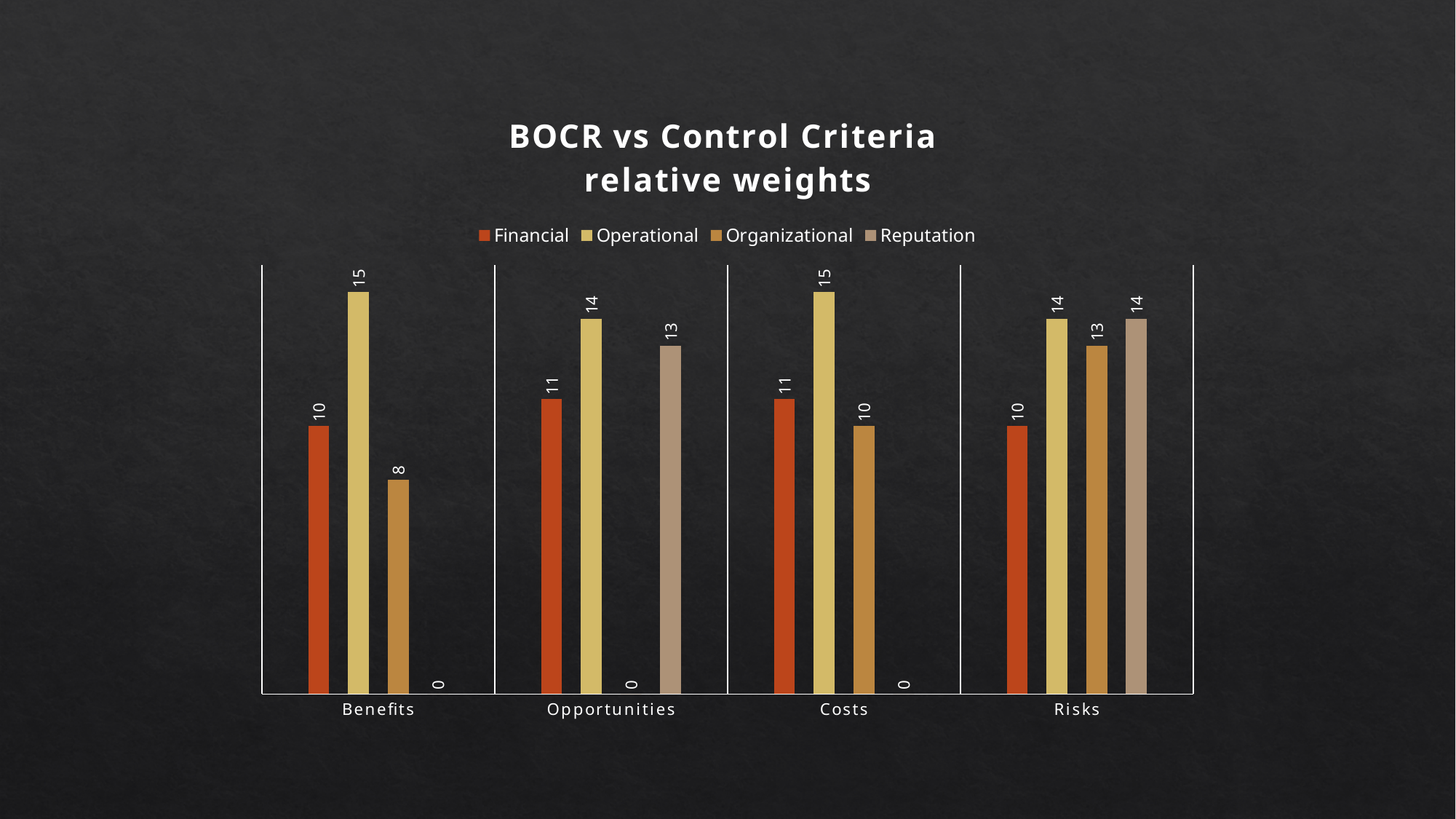
What is the title of the chart? BOCR vs Control Criteria relative weights What is the Operational value for Benefits? 15 What kind of chart is shown on the slide? Bar chart Which series has the lowest value for Benefits? Reputation Which is larger for Risks, the Organizational value or the Reputation value? Reputation How many categories are shown on the x axis? 4 What is the Organizational value for Costs? 10 How many series does the legend list? 4 What is the difference between the Operational and Organizational values for Benefits? 7 Which series has the highest value for Costs? Operational What is the Financial value for Risks? 10 What is the Reputation value for Opportunities? 13